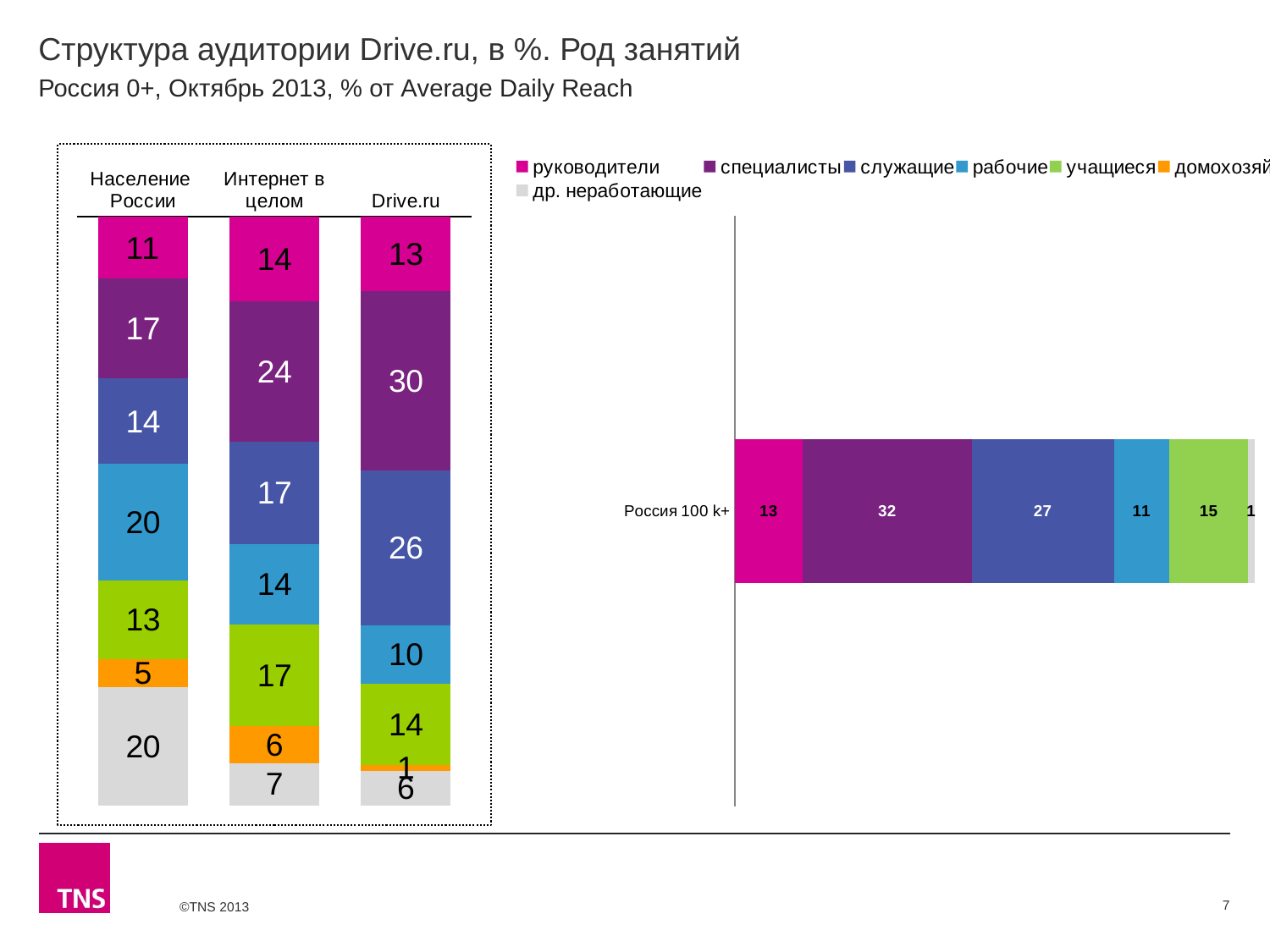
In the left stacked bar chart, what is the value for рабочие in the Население России column? 20 How many series does the legend list? 7 In the left stacked bar chart, which column has the highest value for специалисты? Drive.ru In the left stacked bar chart, what is the value for специалисты in the Drive.ru column? 30 In the right chart (Россия 100 k+), what is the value for служащие? 27 How many columns (categories) are shown in the left stacked bar chart? 3 In the left stacked bar chart, which is larger for руководители: Drive.ru or Интернет в целом? Интернет в целом In the left stacked bar chart, what is the value for учащиеся in the Интернет в целом column? 17 In the right chart (Россия 100 k+), which occupation group has the largest segment? специалисты In the left stacked bar chart, what is the value for др. неработающие in the Drive.ru column? 6 In the right chart (Россия 100 k+), what is the value for руководители? 13 In the left stacked bar chart, what is the difference between the служащие values for Drive.ru and Население России? 12